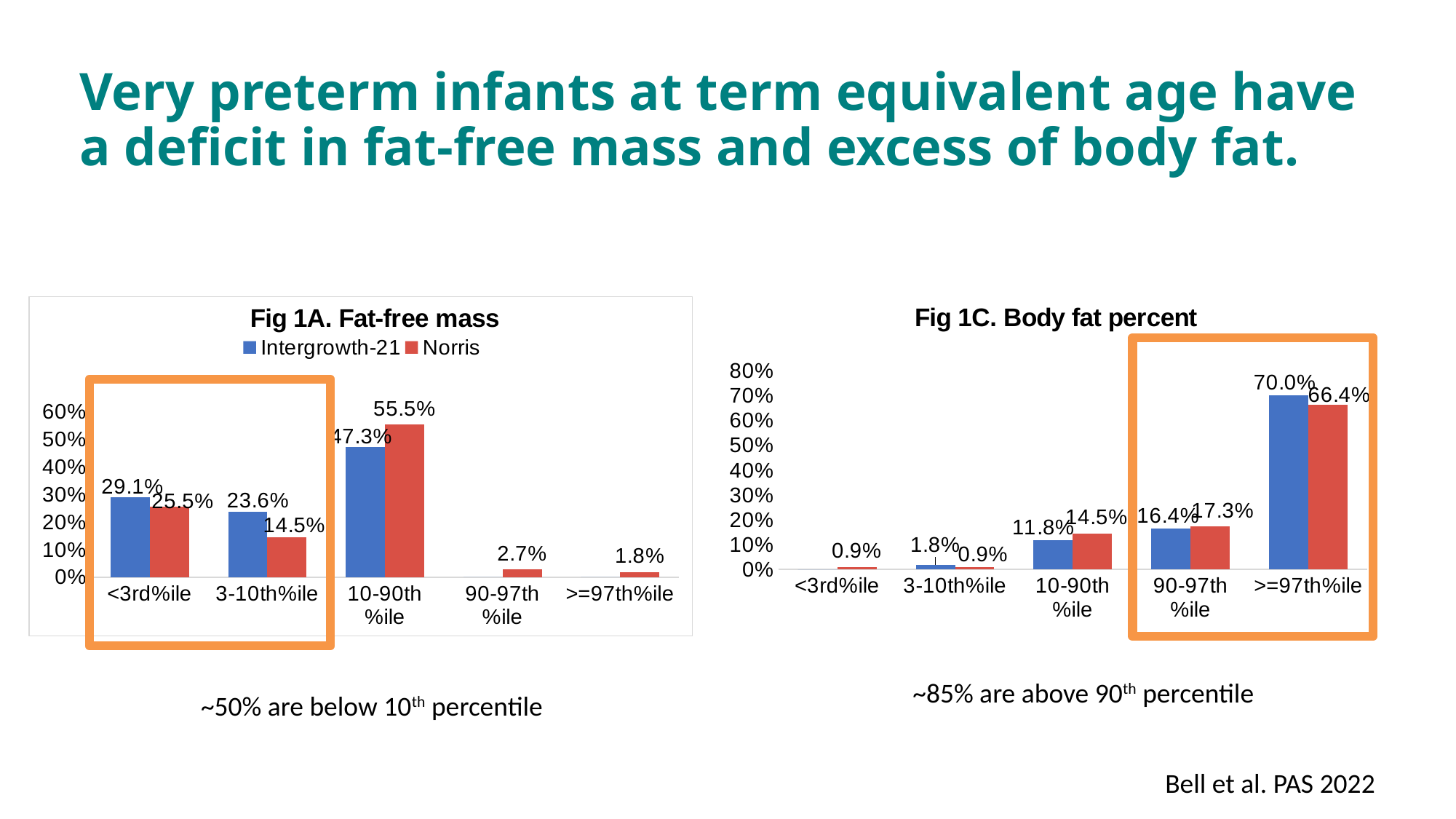
In the Fig 1A. Fat-free mass chart, what is the Intergrowth-21 value for the <3rd%ile category? 29.1% In the Fig 1A. Fat-free mass chart, which category has the highest Intergrowth-21 value? 10-90th%ile In the Fig 1C. Body fat percent chart, what is the difference between the Intergrowth-21 and Norris values for the >=97th%ile category? 3.6% In the Fig 1C. Body fat percent chart, which is larger for the 10-90th%ile category, the Intergrowth-21 value or the Norris value? Norris What type of chart is Fig 1C. Body fat percent? Bar chart How many categories are shown on the x axis of the Fig 1A. Fat-free mass chart? 5 How many series does the legend of the Fig 1A. Fat-free mass chart list? 2 In the Fig 1C. Body fat percent chart, what is the Intergrowth-21 value for the >=97th%ile category? 70.0% In the Fig 1C. Body fat percent chart, what is the Norris value for the 90-97th%ile category? 17.3% In the Fig 1A. Fat-free mass chart, what is the difference between the Intergrowth-21 and Norris values for the 3-10th%ile category? 9.1% In the Fig 1C. Body fat percent chart, which category has the highest Norris value? >=97th%ile In the Fig 1A. Fat-free mass chart, what is the Norris value for the 10-90th%ile category? 55.5%